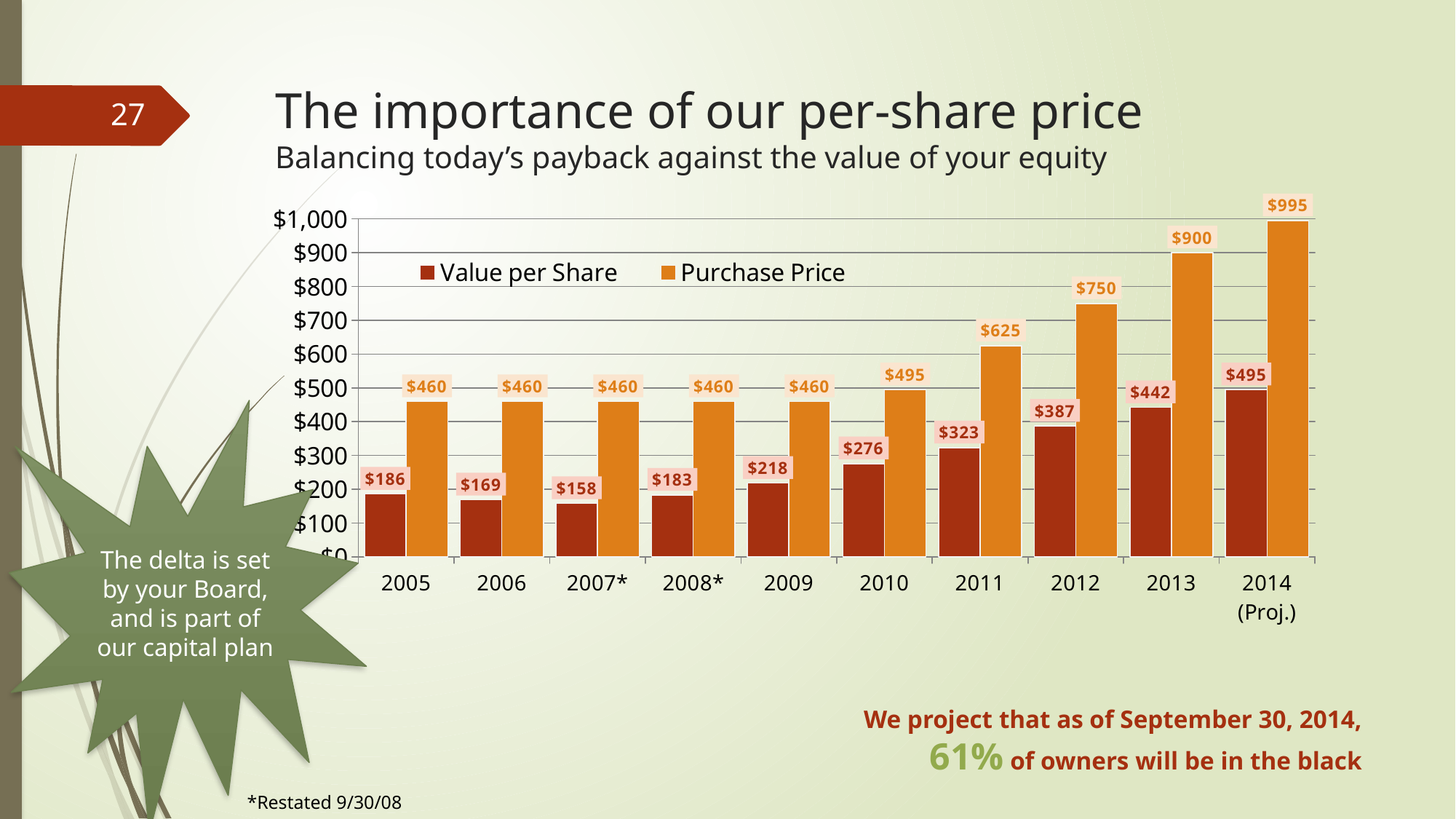
What is the Purchase Price in 2012? $750 What kind of chart is shown on the slide? Bar chart Does the Purchase Price rise or fall from 2009 to 2014 (Proj.)? Rise Which year has the lowest Value per Share? 2007* Which year has the highest Purchase Price? 2014 (Proj.) Which is larger, the Value per Share in 2010 or the Value per Share in 2012? Value per Share in 2012 What is the Value per Share in 2009? $218 Is the Purchase Price in 2011 greater or less than $600? greater What is the difference between the Purchase Price and the Value per Share in 2013? $458 How many series does the legend list? 2 How many years are shown on the x axis? 10 What is the Purchase Price for 2014 (Proj.)? $995